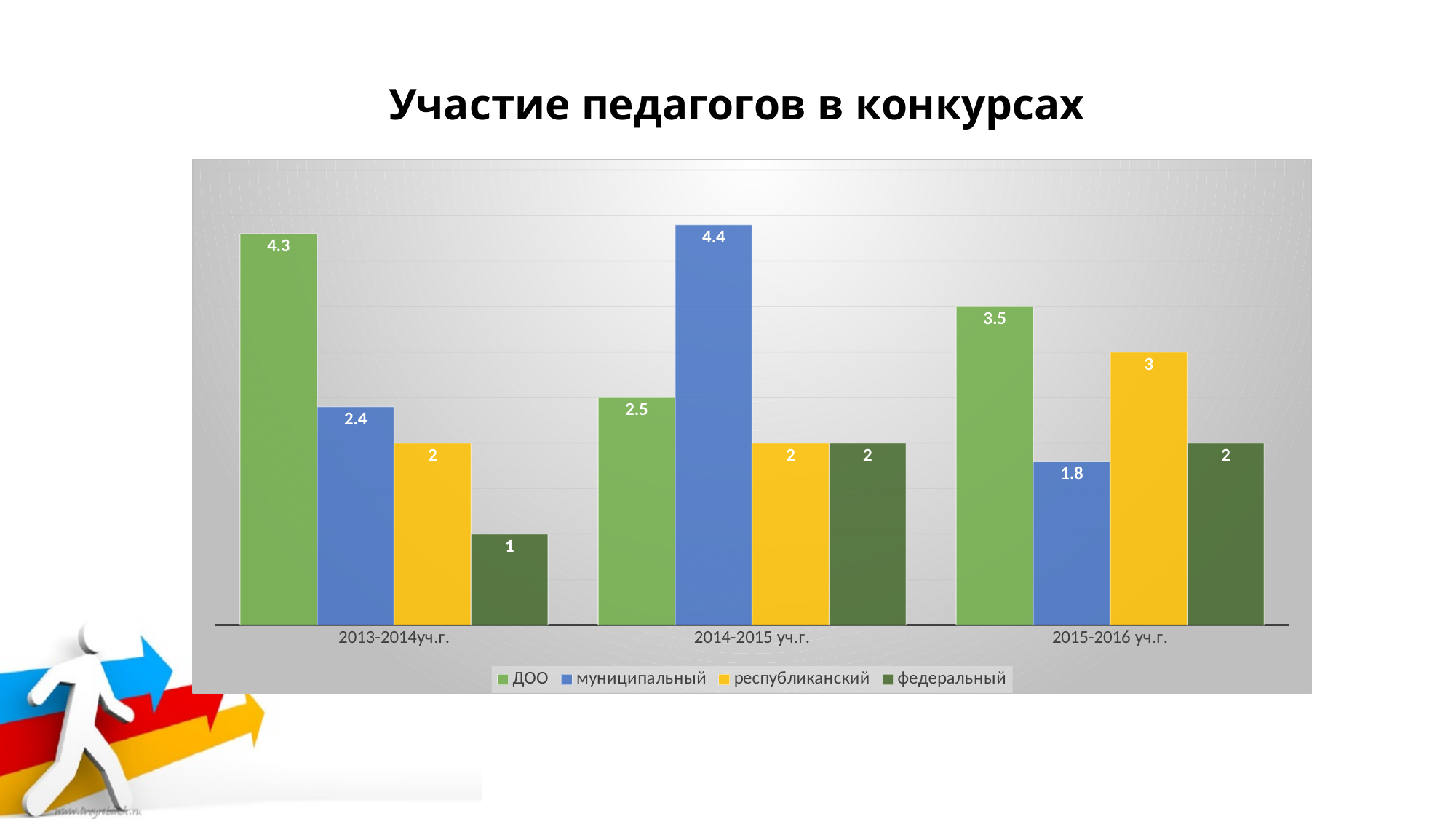
Which series has the lowest value in 2015-2016 уч.г.? муниципальный What kind of chart is shown on the slide? bar chart What is the difference between the ДОО value in 2013-2014уч.г. and the ДОО value in 2015-2016 уч.г.? 0.8 What is the title of the chart? Участие педагогов в конкурсах How many series does the legend list? 4 What is the value for республиканский in 2015-2016 уч.г.? 3 What is the value for федеральный in 2013-2014уч.г.? 1 How many categories are shown on the x axis? 3 Which series has the highest value in 2014-2015 уч.г.? муниципальный What is the value for ДОО in 2013-2014уч.г.? 4.3 What is the value for муниципальный in 2014-2015 уч.г.? 4.4 Which is larger: the муниципальный value in 2013-2014уч.г. or the муниципальный value in 2015-2016 уч.г.? 2013-2014уч.г.